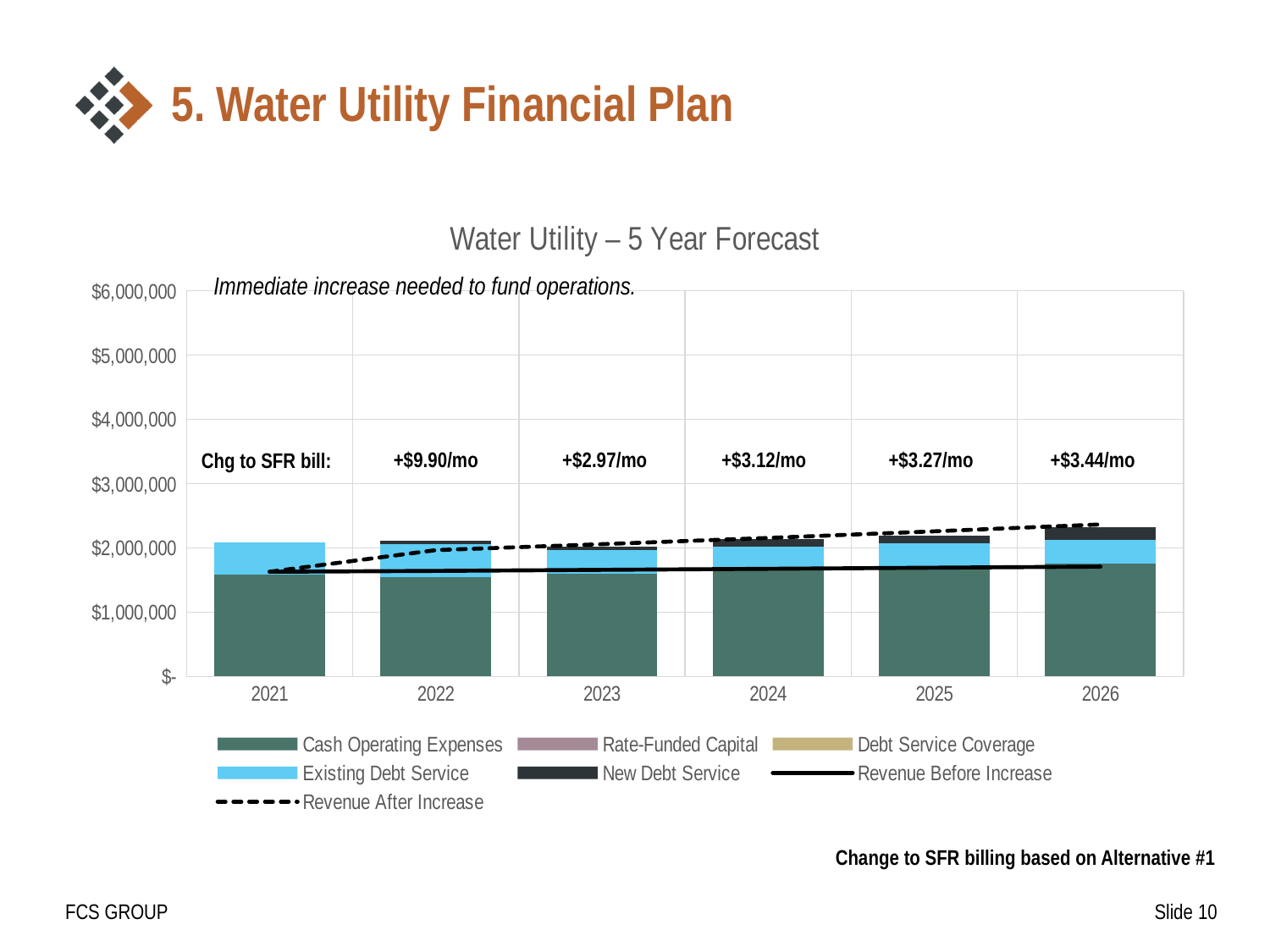
In which year is the change to the SFR bill the largest? 2022 What is the title of the chart? Water Utility – 5 Year Forecast What type of chart is shown on the slide? Stacked bar chart with line series Is the Cash Operating Expenses value for 2021 greater or less than $2,000,000? less In which year is the change to the SFR bill the smallest? 2023 What is the change to the SFR bill shown for 2025? +$3.27/mo Does the Revenue After Increase line rise or fall from 2021 to 2026? rise How many series does the chart legend list? 7 Which year has a larger change to the SFR bill, 2024 or 2026? 2026 How many years are shown on the x axis of the chart? 6 What is the change to the SFR bill shown for 2022? +$9.90/mo How much larger is the change to the SFR bill in 2022 than in 2023? $6.93/mo